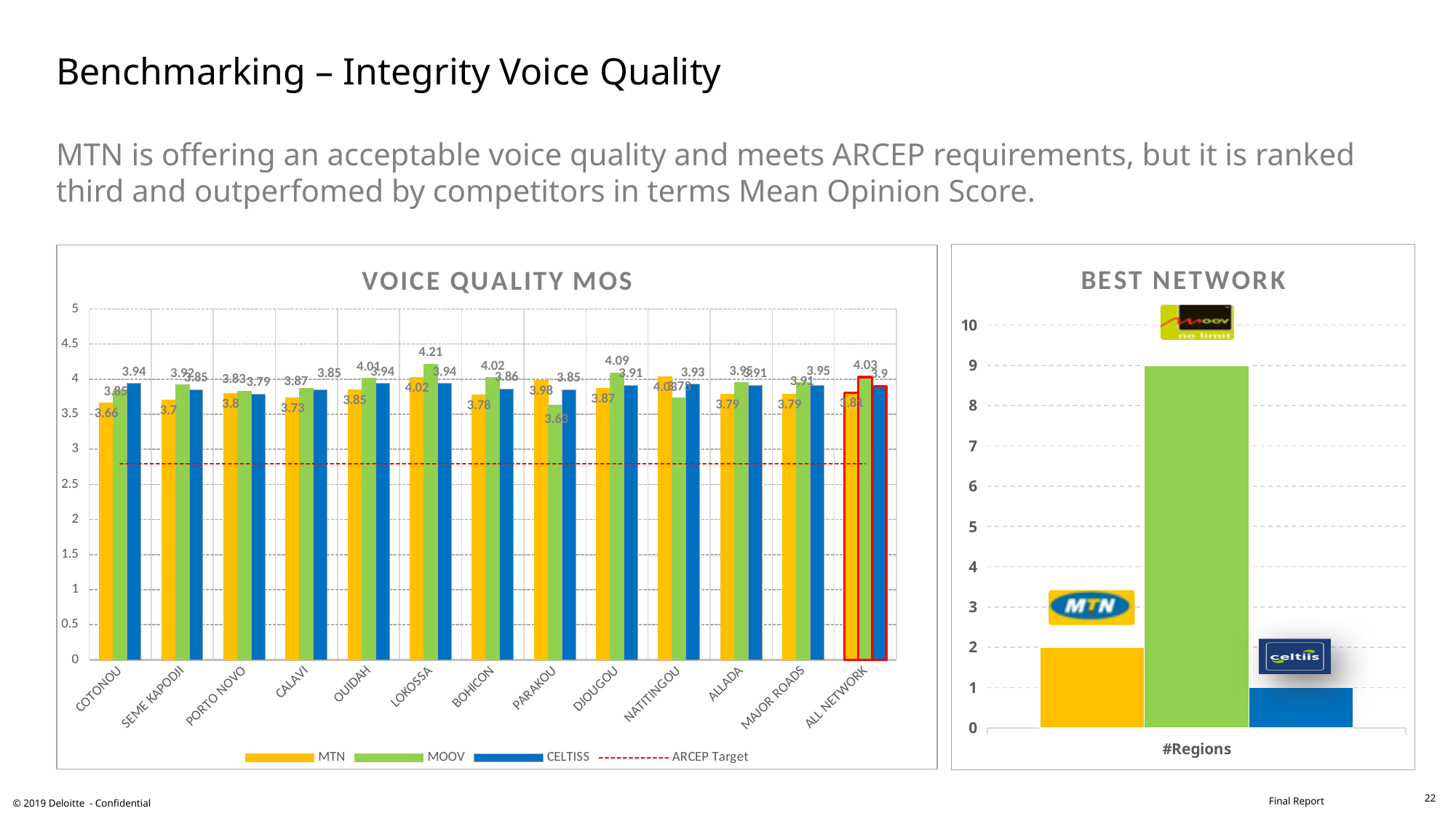
In the VOICE QUALITY MOS chart, what is the difference between the MOOV and MTN values for ALL NETWORK? 0.22 What kind of chart is the VOICE QUALITY MOS chart? bar chart In the BEST NETWORK chart, how many regions does MOOV have? 9 How many entries does the legend of the VOICE QUALITY MOS chart list? 4 In the VOICE QUALITY MOS chart, which category has the lowest MTN value? COTONOU In the VOICE QUALITY MOS chart, what is the MOOV value for LOKOSSA? 4.21 In the VOICE QUALITY MOS chart, what is the MTN value for ALL NETWORK? 3.81 In the VOICE QUALITY MOS chart, which is larger for PARAKOU, the MTN value or the MOOV value? MTN How many categories are shown on the x axis of the VOICE QUALITY MOS chart? 13 In the VOICE QUALITY MOS chart, is the ARCEP Target line greater or less than 3? less In the VOICE QUALITY MOS chart, which category has the highest MOOV value? LOKOSSA In the BEST NETWORK chart, which operator has the highest bar? MOOV